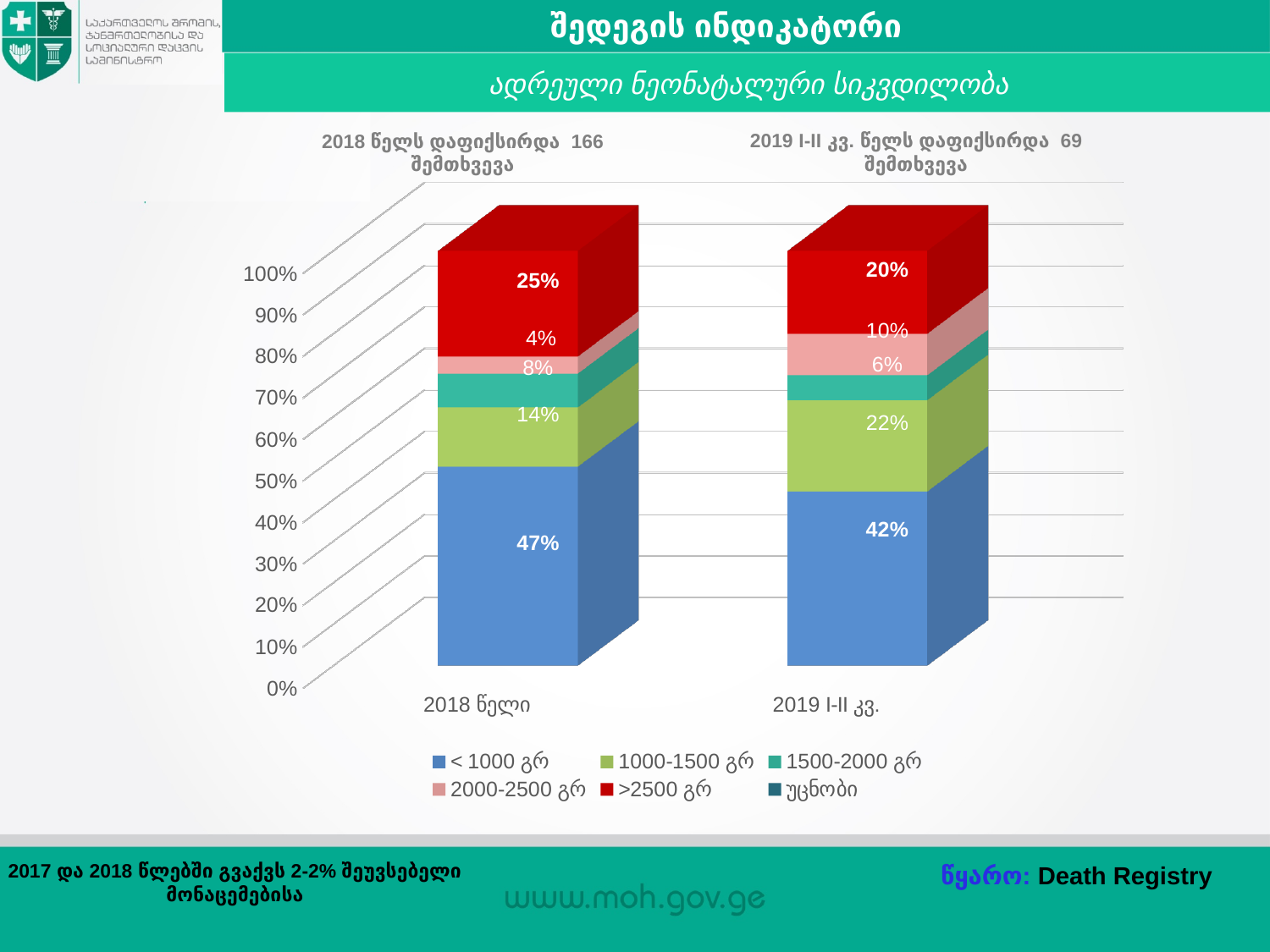
What is the value of the 1000-1500 გრ segment for 2019 I-II კვ.? 22% Which segment is the largest in the 2018 წელი bar? < 1000 გრ What is the value of the 1500-2000 გრ segment for 2018 წელი? 8% What is the value of the 2000-2500 გრ segment for 2019 I-II კვ.? 10% What is the value of the >2500 გრ segment for 2018 წელი? 25% What is the difference between the 1000-1500 გრ segments for 2019 I-II კვ. and 2018 წელი? 8% Which bar has the larger >2500 გრ segment, 2018 წელი or 2019 I-II კვ.? 2018 წელი How many bars (categories) are plotted on the x axis? 2 What is the value of the < 1000 გრ segment for 2019 I-II კვ.? 42% How many series does the legend list? 6 What kind of chart is shown on the slide? stacked bar chart What is the value of the < 1000 გრ segment for 2018 წელი? 47%